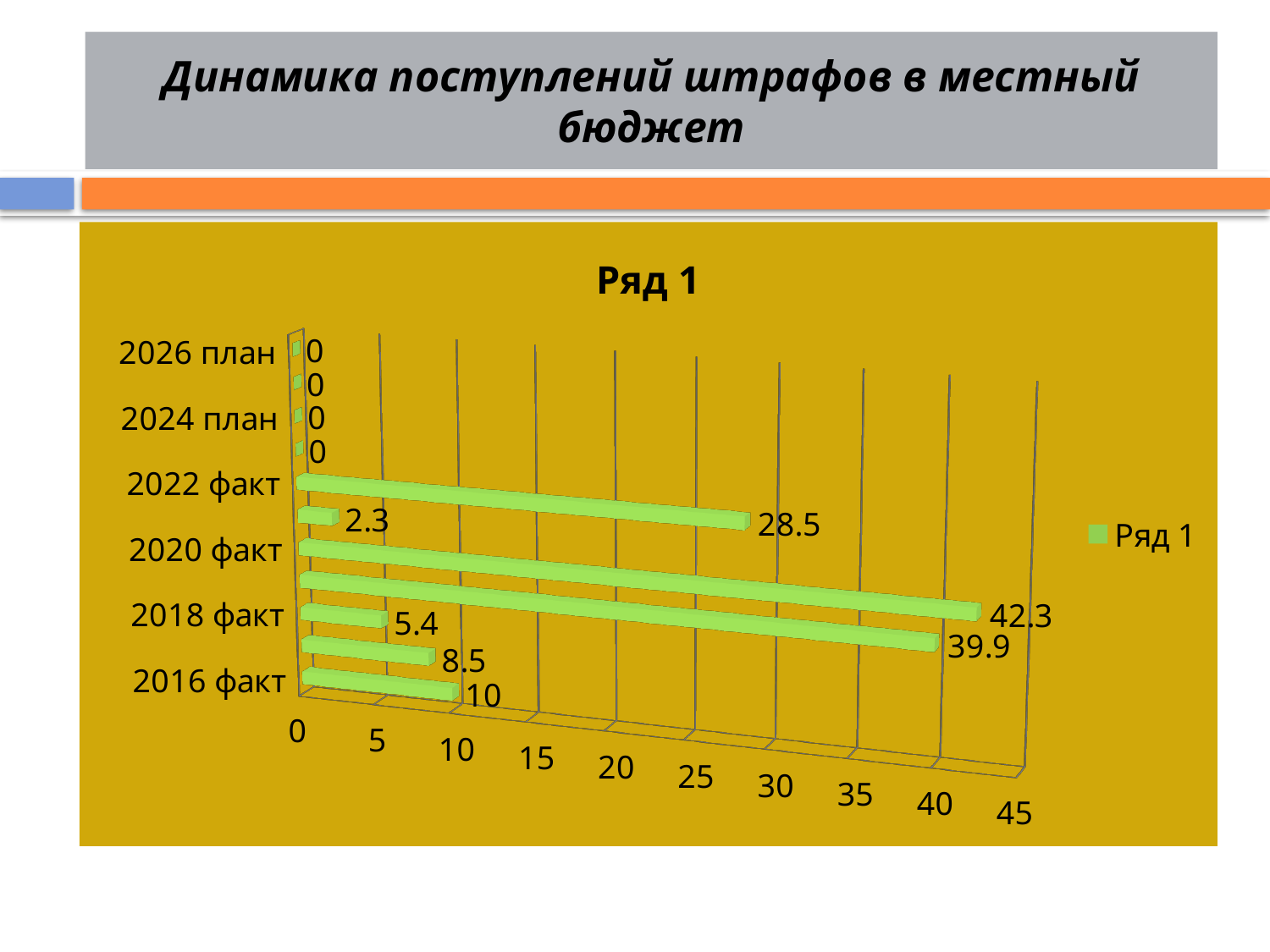
How many series does the legend list? 1 What is the value for 2016 факт? 10 What is the value for 2018 факт? 5.4 What is the name of the series shown in the legend? Ряд 1 Is the value for 2022 факт greater or less than 25? greater What is the value for 2020 факт? 42.3 Which is larger, the value for 2016 факт or the value for 2018 факт? 2016 факт What is the value for 2024 план? 0 Which category has the highest value? 2020 факт What kind of chart is shown on the slide? bar chart What is the difference between the values for 2020 факт and 2022 факт? 13.8 What is the value for 2022 факт? 28.5